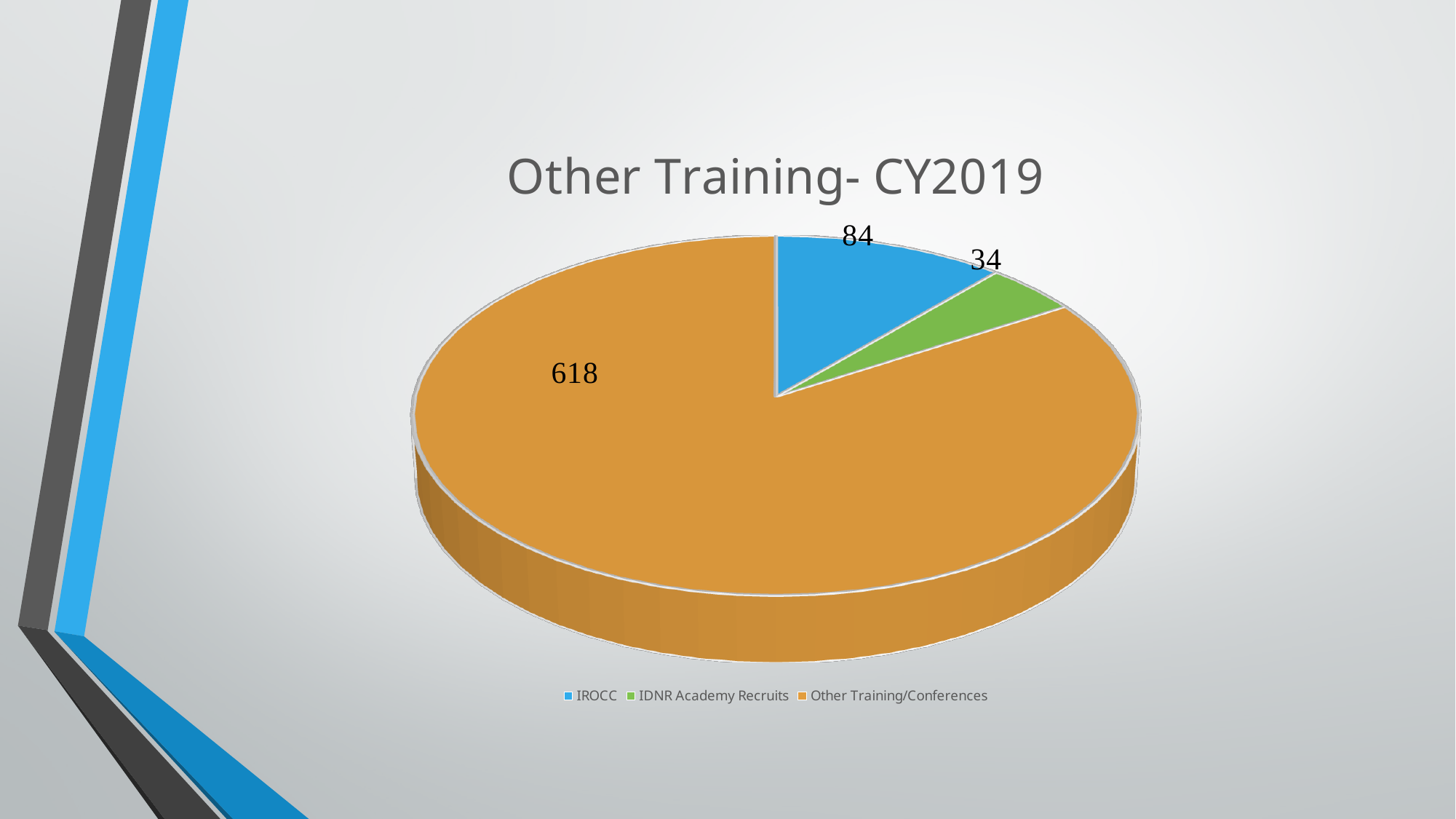
What colour is the slice for IDNR Academy Recruits? Green What is the value for Other Training/Conferences? 618 What is the title of the chart? Other Training- CY2019 What is the value for IDNR Academy Recruits? 34 What type of chart is shown on the slide? Pie chart What is the difference between the values for Other Training/Conferences and IROCC? 534 How many categories does the pie chart show? 3 Which category has the smallest slice? IDNR Academy Recruits What is the value for IROCC? 84 Which is larger, the value for IROCC or the value for IDNR Academy Recruits? IROCC What is the difference between the values for IROCC and IDNR Academy Recruits? 50 Which category has the largest slice? Other Training/Conferences